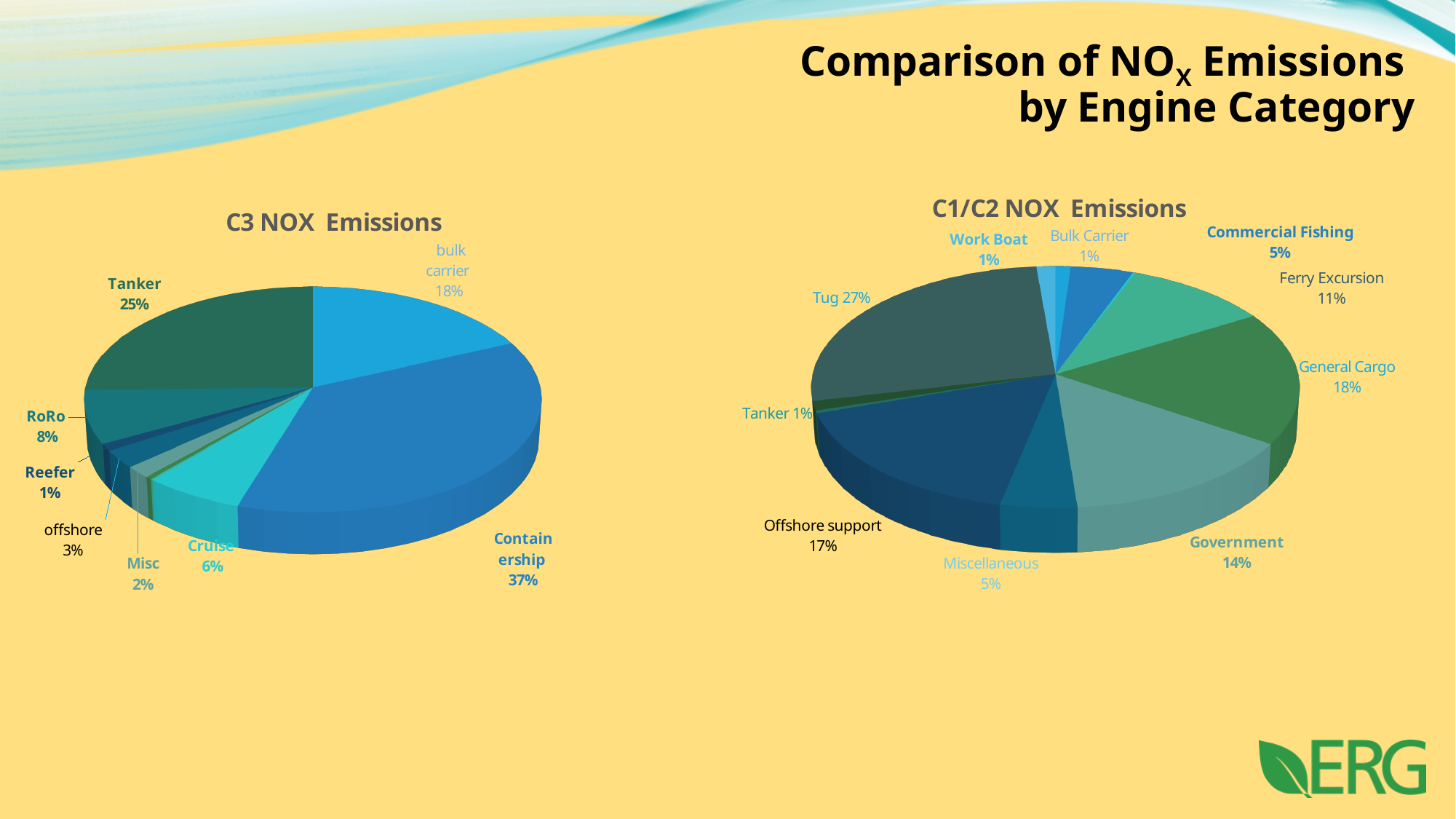
In the C1/C2 NOX Emissions chart, which category has the largest share? Tug In the C1/C2 NOX Emissions chart, what share does Offshore support have? 17% In the C1/C2 NOX Emissions chart, which is larger, General Cargo or Government? General Cargo In the C1/C2 NOX Emissions chart, what share does Tug have? 27% In the C3 NOX Emissions chart, what share does Tanker have? 25% What type of chart is used for the C1/C2 NOX Emissions? Pie chart In the C3 NOX Emissions chart, which category has the largest share? Containership In the C3 NOX Emissions chart, what share does Containership have? 37% In the C3 NOX Emissions chart, what is the difference between the Containership and bulk carrier shares? 19%